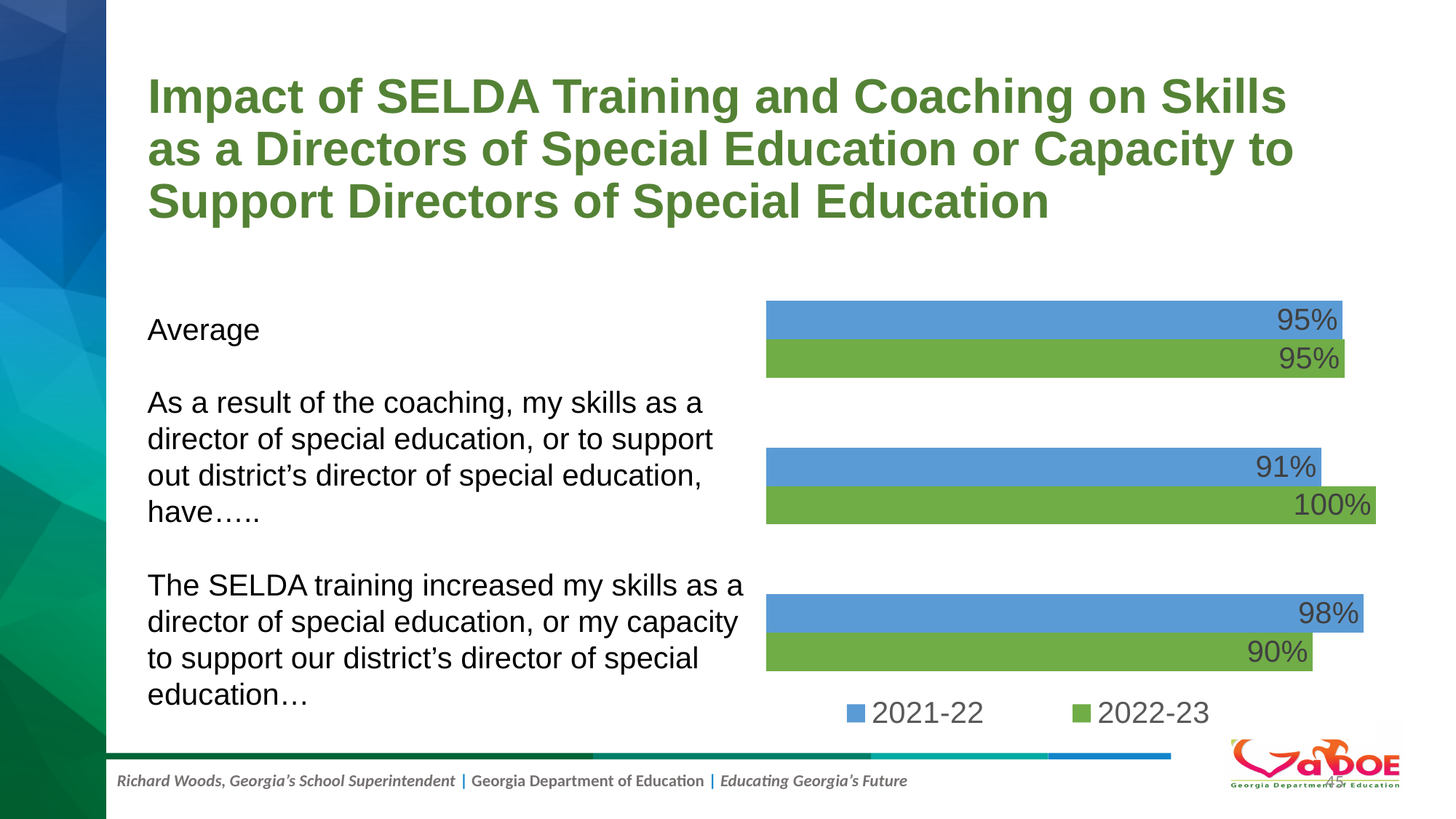
How many categories are shown in the chart? 3 What is the 2021-22 value for the "Average" category? 95% Which category has the highest 2022-23 value? As a result of the coaching, my skills as a director of special education, or to support out district's director of special education, have….. What is the 2022-23 value for the category beginning "As a result of the coaching, my skills as a director of special education"? 100% What is the 2022-23 value for the category beginning "The SELDA training increased my skills as a director of special education"? 90% What is the difference between the 2022-23 and 2021-22 values for the category beginning "As a result of the coaching"? 9% For the category beginning "The SELDA training increased my skills", which series has the larger value, 2021-22 or 2022-23? 2021-22 What kind of chart is shown on the slide? Bar chart What is the 2021-22 value for the category beginning "The SELDA training increased my skills as a director of special education"? 98% Which colour represents the 2022-23 series in the chart? Green Which category has the lowest 2021-22 value? As a result of the coaching, my skills as a director of special education, or to support out district's director of special education, have….. How many series does the legend list? 2